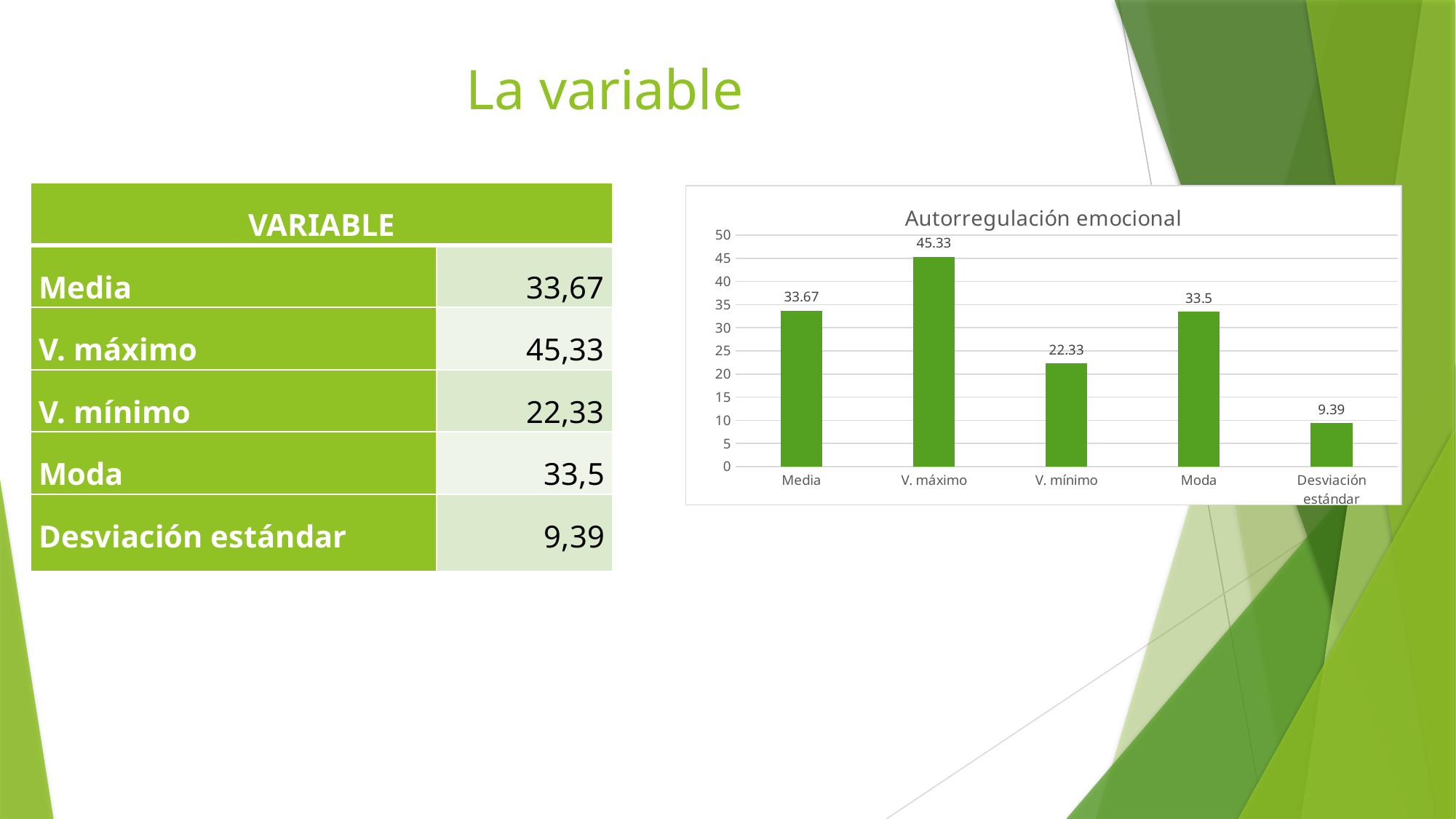
What is the title of the chart? Autorregulación emocional What is the value for V. máximo in the chart? 45.33 What is the difference between the values for V. máximo and V. mínimo? 23 Is the value for Moda greater or less than 30? greater How many categories are shown on the x axis of the chart? 5 Which is larger, the value for Media or the value for V. mínimo? Media Which category has the lowest value in the chart? Desviación estándar What kind of chart is shown on the slide? bar chart What is the difference between the values for Media and Moda? 0.17 What is the value for Desviación estándar in the chart? 9.39 What is the value for V. mínimo in the chart? 22.33 Which category has the highest value in the chart? V. máximo